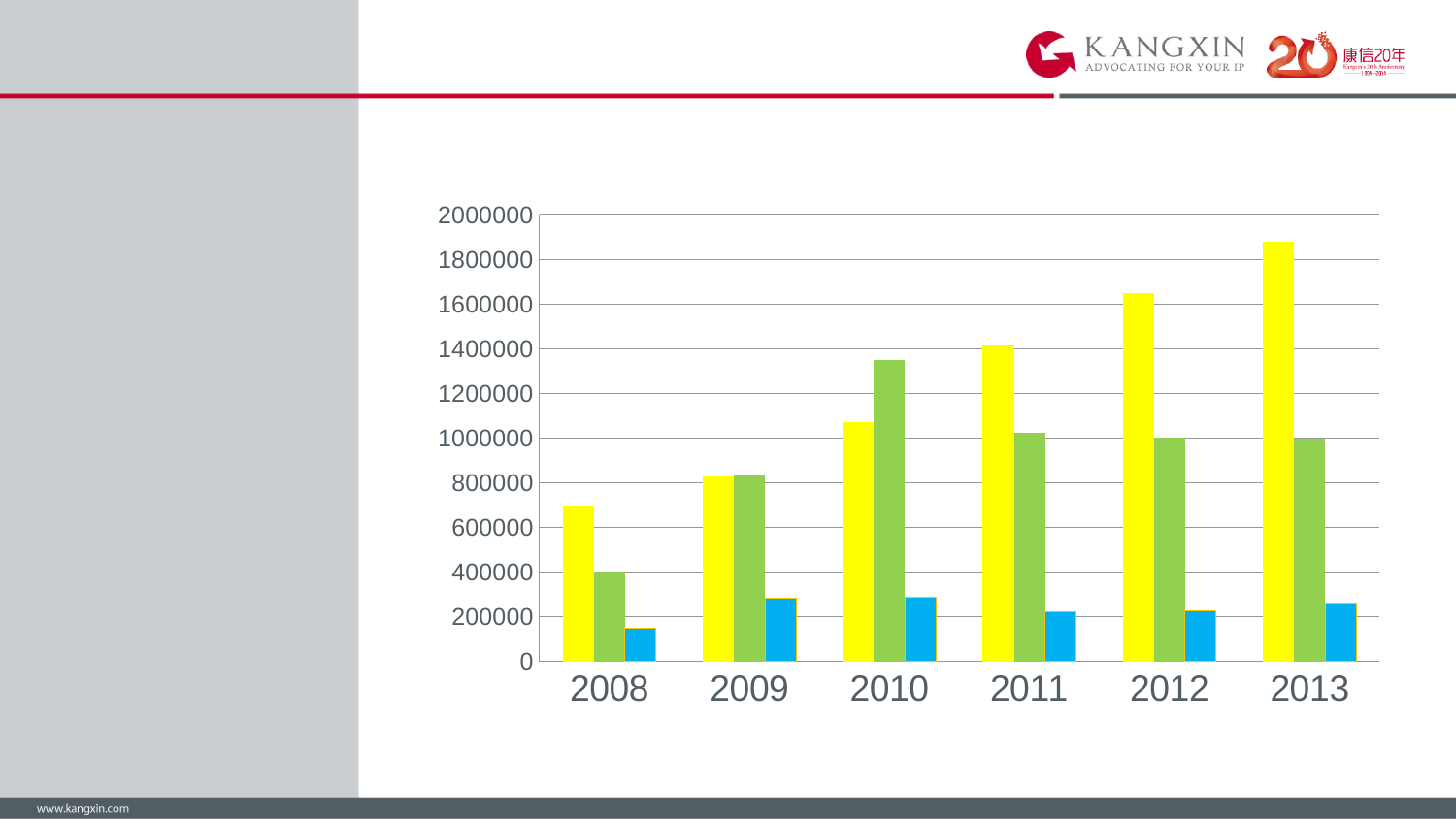
In which year is the yellow bar the tallest? 2013 In which year is the green bar the tallest? 2010 What kind of chart is shown on the slide? bar chart In 2010, which is larger, the yellow bar or the green bar? green bar How many years are shown on the x axis of the chart? 6 How many bars are plotted for each year in the chart? 3 Is the value of the yellow bar for 2013 greater or less than 1800000? greater In which year is the blue bar the shortest? 2008 In 2013, which is larger, the yellow bar or the green bar? yellow bar Do the yellow bars rise or fall from 2008 to 2013? rise Is the value of the green bar for 2008 greater or less than 600000? less In which year is the yellow bar the shortest? 2008